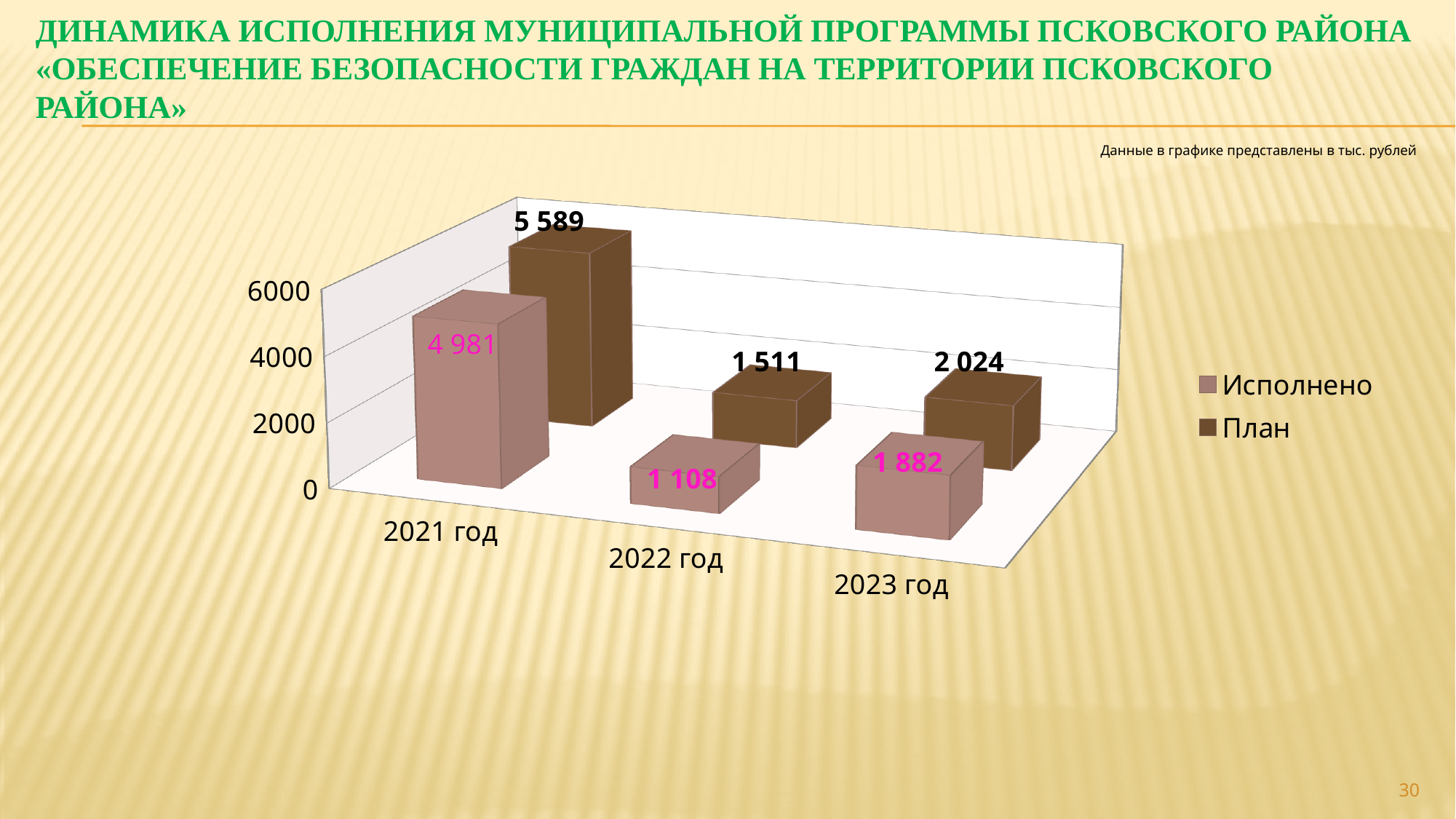
What is the difference between "План" and "Исполнено" for 2023 год? 142 What is the value of "План" for 2022 год? 1 511 How many years are shown on the x axis? 3 Which is larger: "Исполнено" for 2023 год or "Исполнено" for 2022 год? Исполнено for 2023 год What kind of chart is shown on the slide? Bar chart What is the value of "План" for 2021 год? 5 589 How many series does the legend list? 2 What is the difference between "План" and "Исполнено" for 2021 год? 608 Which year has the lowest "Исполнено" value? 2022 год What is the value of "Исполнено" for 2023 год? 1 882 Which year has the highest "План" value? 2021 год What is the value of "Исполнено" for 2022 год? 1 108